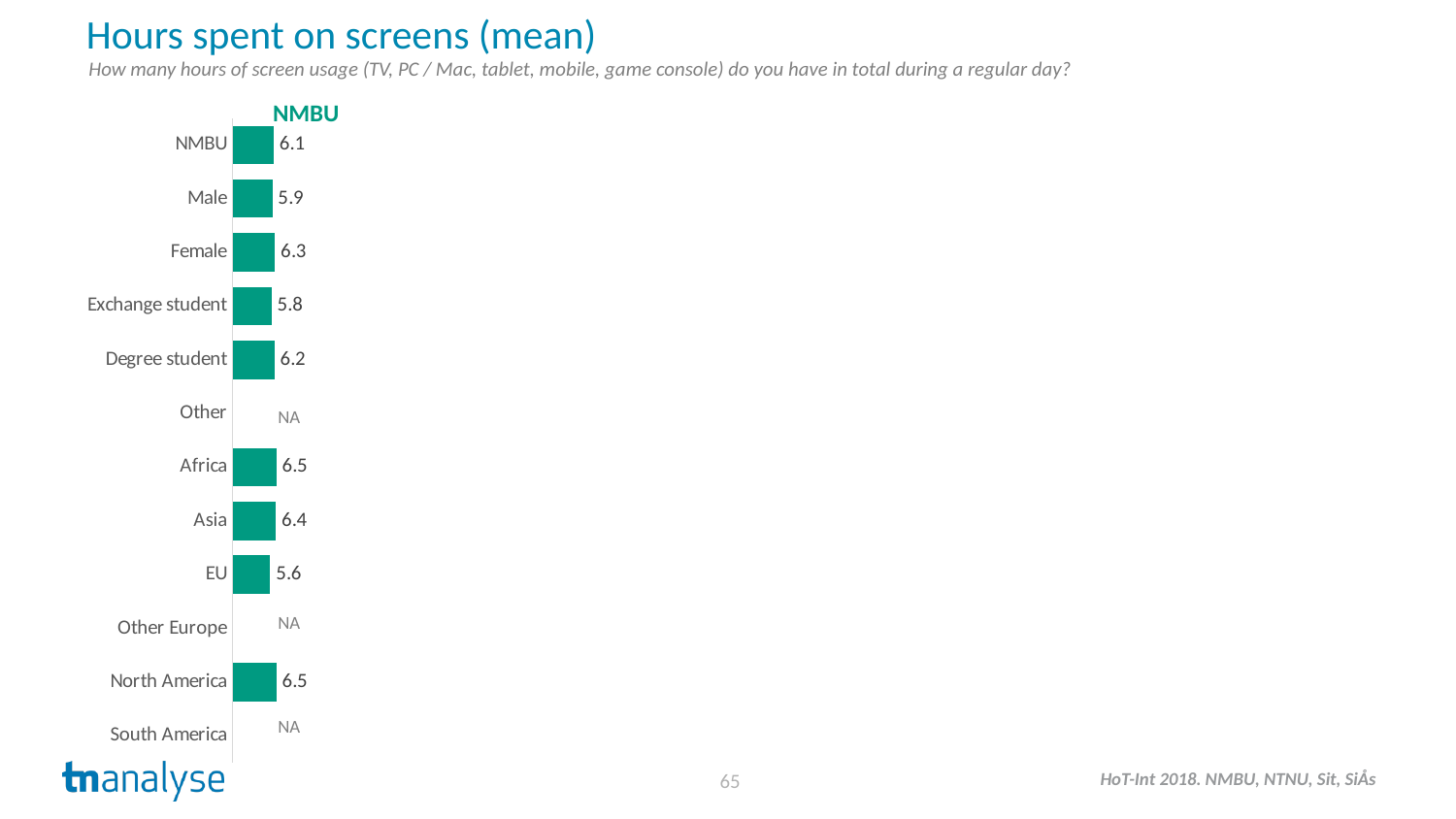
Which category has the lowest plotted value? EU What is the mean hours spent on screens for Female? 6.3 What is the title of the chart? Hours spent on screens (mean) What is the value shown for Asia? 6.4 What is the value shown for NMBU? 6.1 What kind of chart is shown on the slide? Bar chart Which is larger, the value for Degree student or the value for Exchange student? Degree student What is the difference between the values for Female and Male? 0.4 What is the value shown for Exchange student? 5.8 What is the difference between the values for Africa and EU? 0.9 How many categories are listed on the chart? 12 What is shown for Other Europe? NA